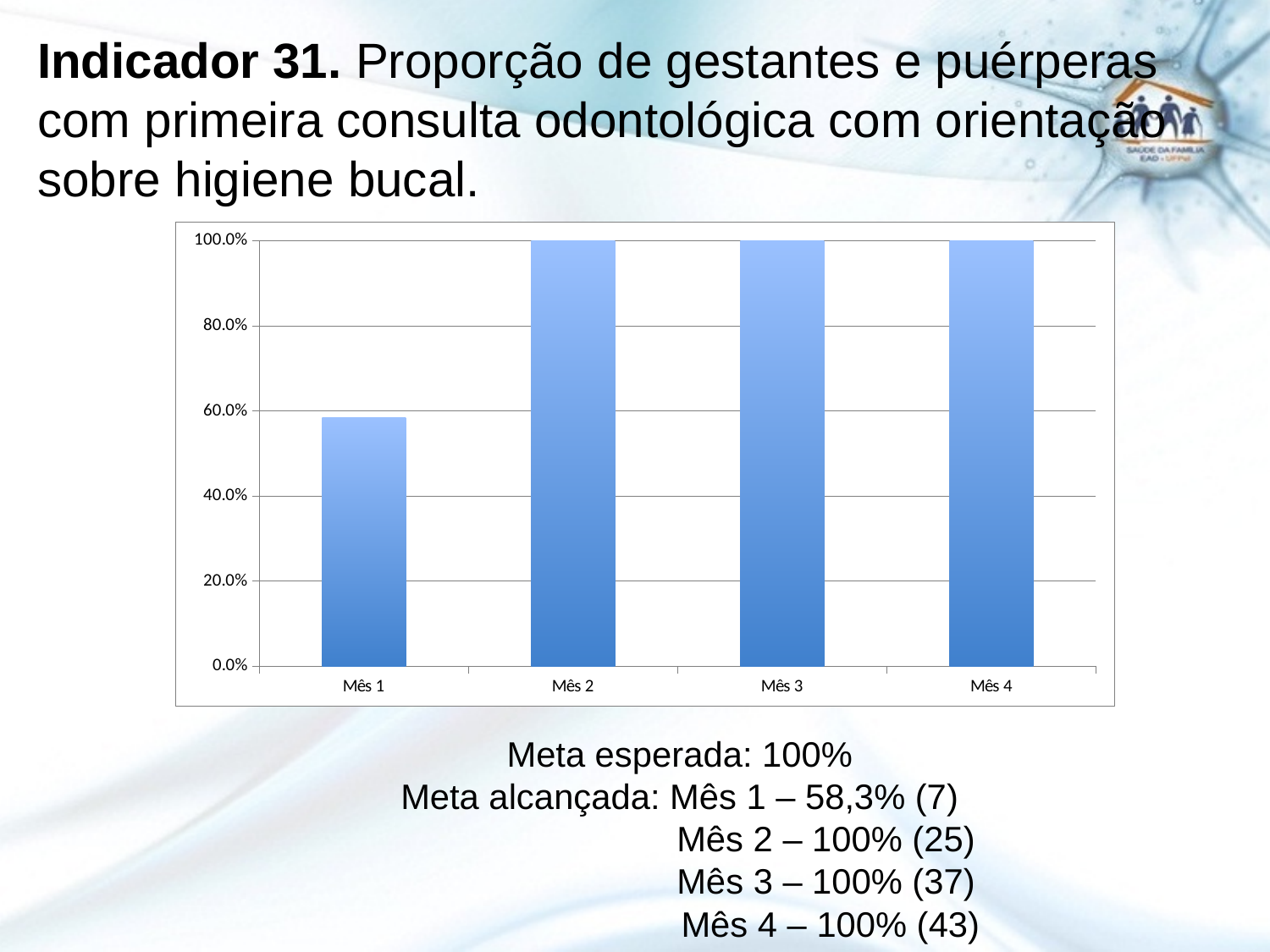
Which month has the lowest value? Mês 1 Is the value for Mês 1 greater or less than 60.0%? less What is the difference between the value for Mês 2 and the value for Mês 1? 41,7% What kind of chart is shown? bar chart Which is larger, the value for Mês 1 or the value for Mês 2? Mês 2 Do the values rise or fall from Mês 1 to Mês 2? rise According to the slide, what proportion was reached in Mês 1? 58,3% What is the value for Mês 2? 100% What is the value for Mês 4? 100% How many months are shown on the x axis? 4 What is the expected target (meta esperada) stated on the slide? 100% Is the value for Mês 3 greater or less than 80.0%? greater